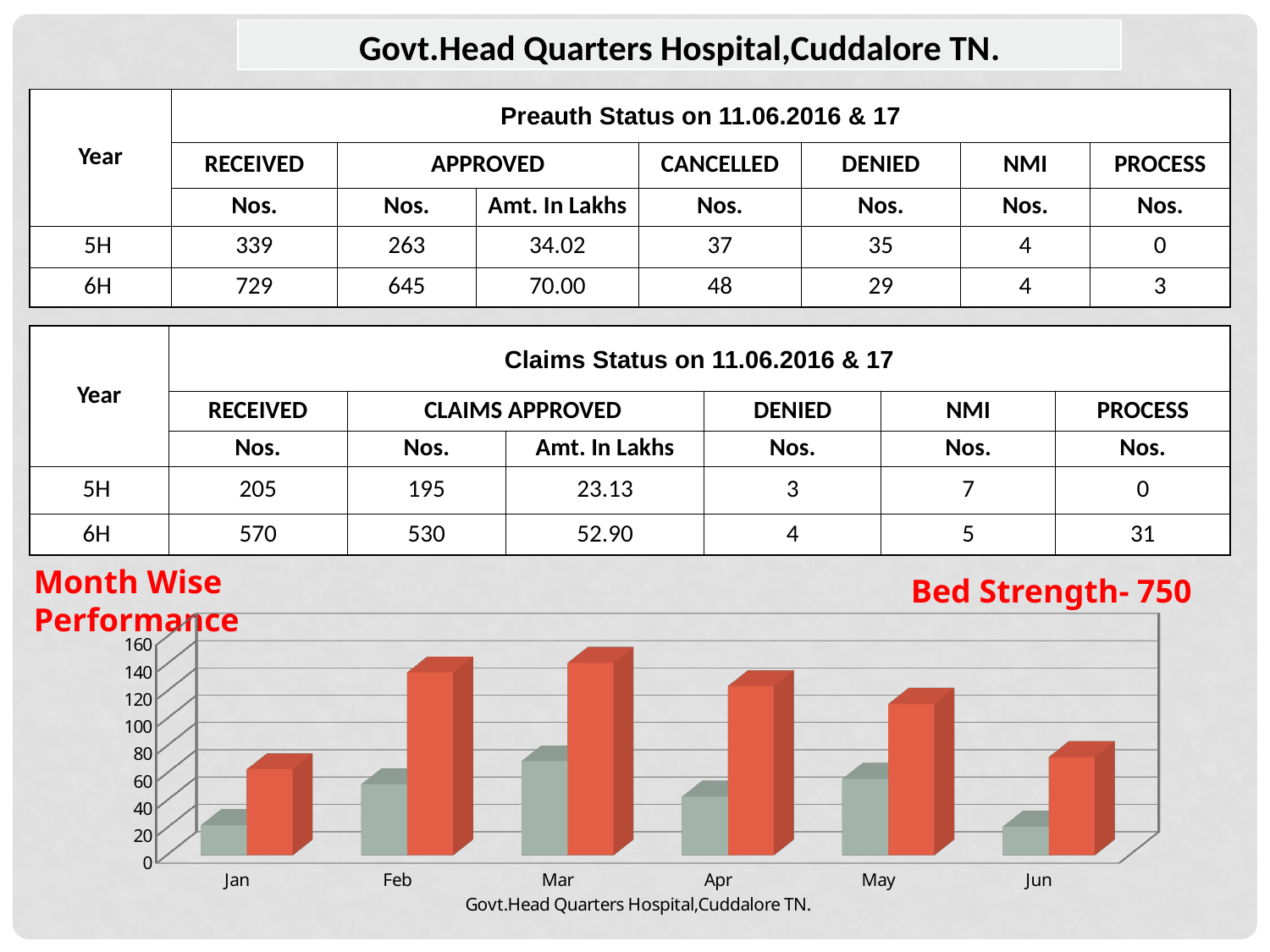
In which month is the grey bar the tallest? Mar How many bars are plotted for each month in the chart? 2 In which month is the orange bar the tallest? Mar Is the value of the grey bar for Apr greater or less than 60? less How many months are shown on the x axis of the chart? 6 Which is larger, the orange bar for Feb or the orange bar for Apr? Feb Is the value of the grey bar for Jan greater or less than 40? less Is the value of the orange bar for Mar greater or less than 120? greater What kind of chart is shown on the slide? bar chart What is the highest value shown on the chart's vertical axis? 160 Which is larger, the grey bar for Mar or the grey bar for Jan? Mar